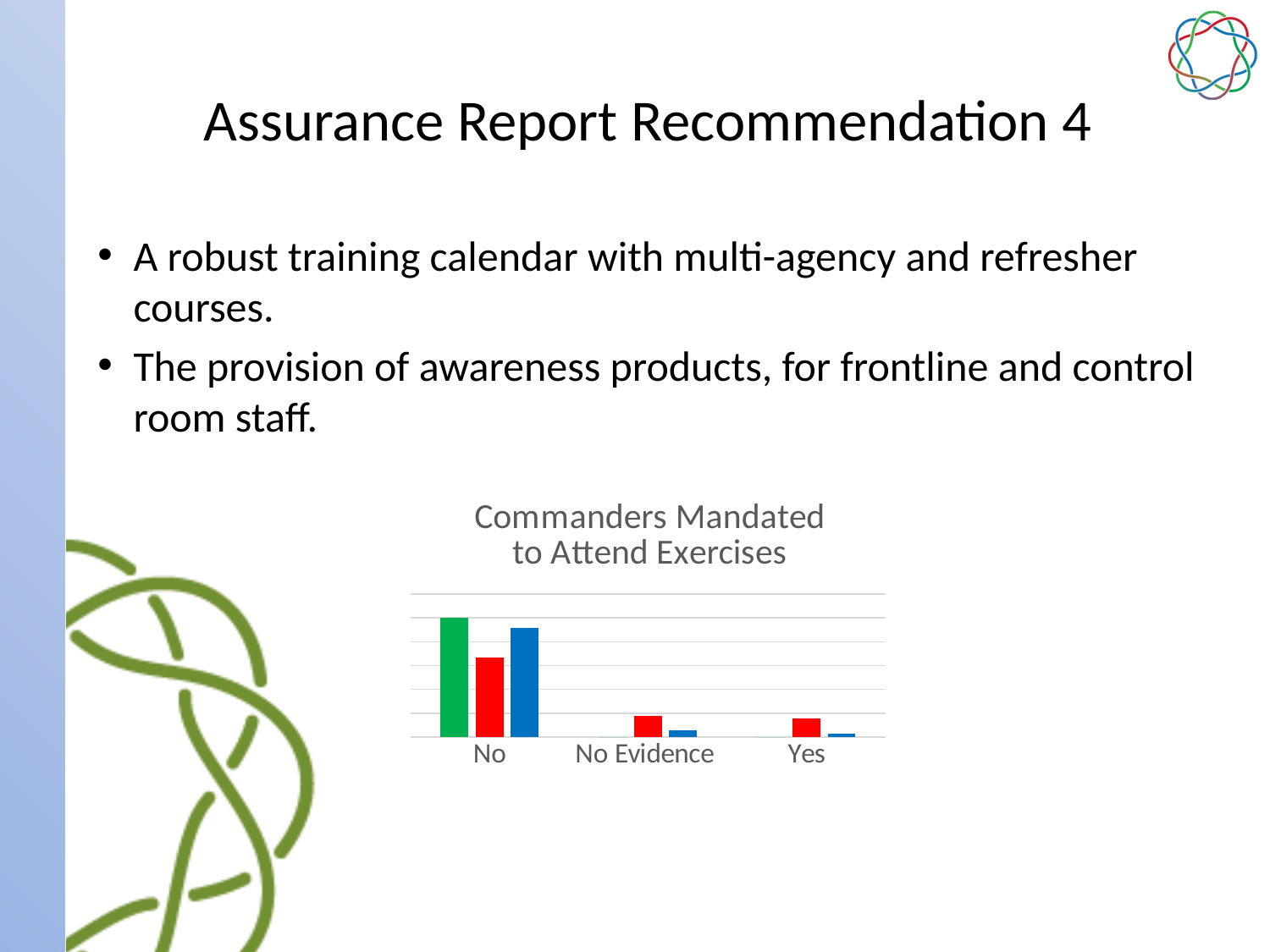
Which category has larger bars, No or No Evidence? No What kind of chart is shown on the slide? bar chart Which category is the only one with a green bar? No How many categories are shown on the x axis of the chart? 3 In the No category, which bar is taller, the green bar or the red bar? green Which category has the tallest bars in the chart? No Which category has larger bars, No or Yes? No What is the title of the chart? Commanders Mandated to Attend Exercises How many bars are shown for the No category? 3 Do the bar heights rise or fall moving from No to Yes along the x axis? fall